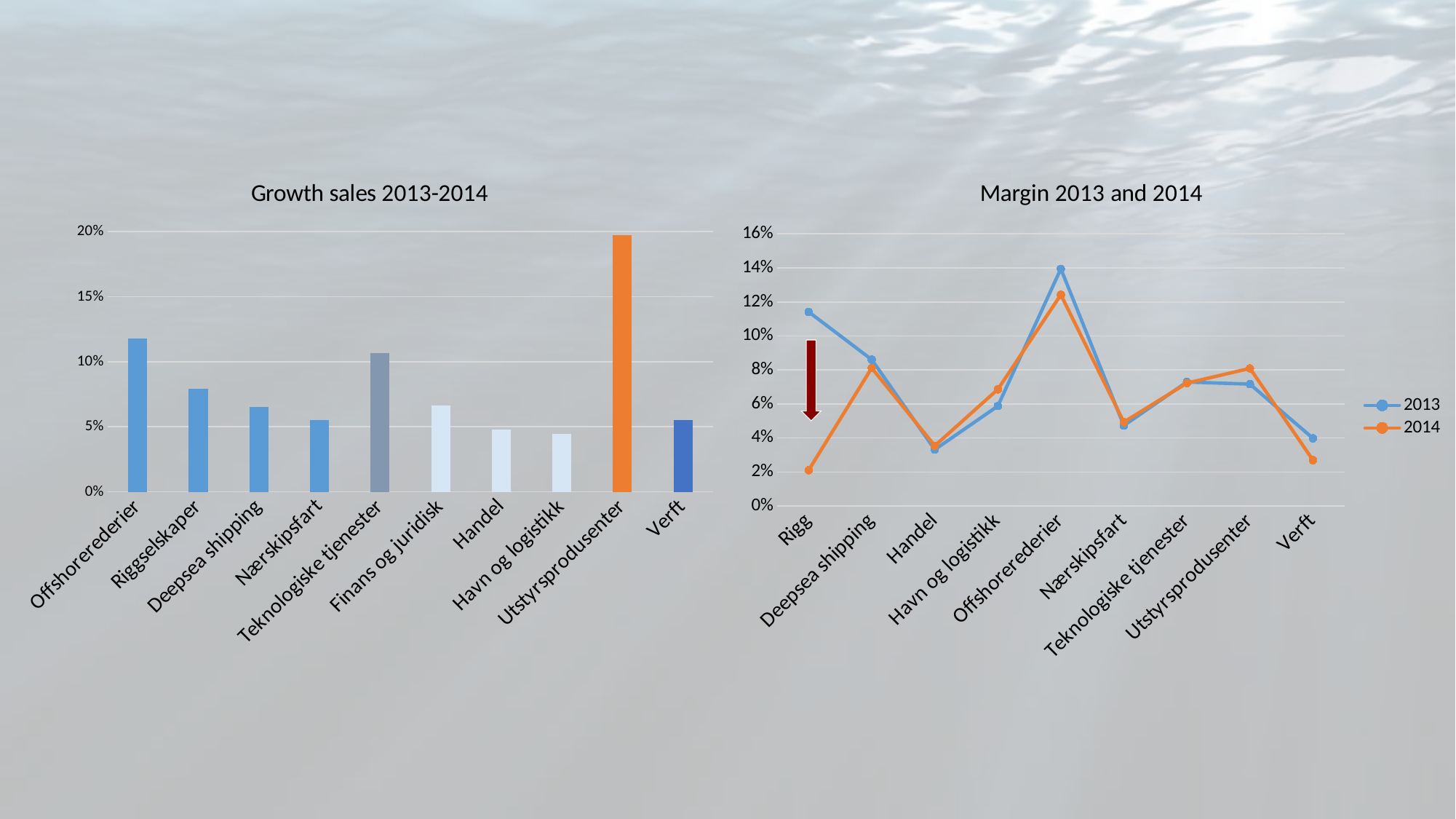
What kind of chart is the 'Margin 2013 and 2014' chart? line chart What kind of chart is the 'Growth sales 2013-2014' chart? bar chart In the 'Growth sales 2013-2014' chart, is the value for Utstyrsprodusenter greater or less than 15%? greater In the 'Margin 2013 and 2014' chart, how many series does the legend list? 2 In the 'Margin 2013 and 2014' chart, what are the two entries in the legend? 2013 and 2014 In the 'Margin 2013 and 2014' chart, which category has the highest 2013 value? Offshorerederier In the 'Margin 2013 and 2014' chart, is the 2013 value for Rigg greater or less than 10%? greater In the 'Margin 2013 and 2014' chart, which category has the lowest 2014 value? Rigg In the 'Growth sales 2013-2014' chart, which is larger, the value for Offshorerederier or the value for Riggselskaper? Offshorerederier In the 'Growth sales 2013-2014' chart, which category has the highest value? Utstyrsprodusenter In the 'Growth sales 2013-2014' chart, is the value for Offshorerederier greater or less than 10%? greater In the 'Growth sales 2013-2014' chart, how many categories are shown? 10